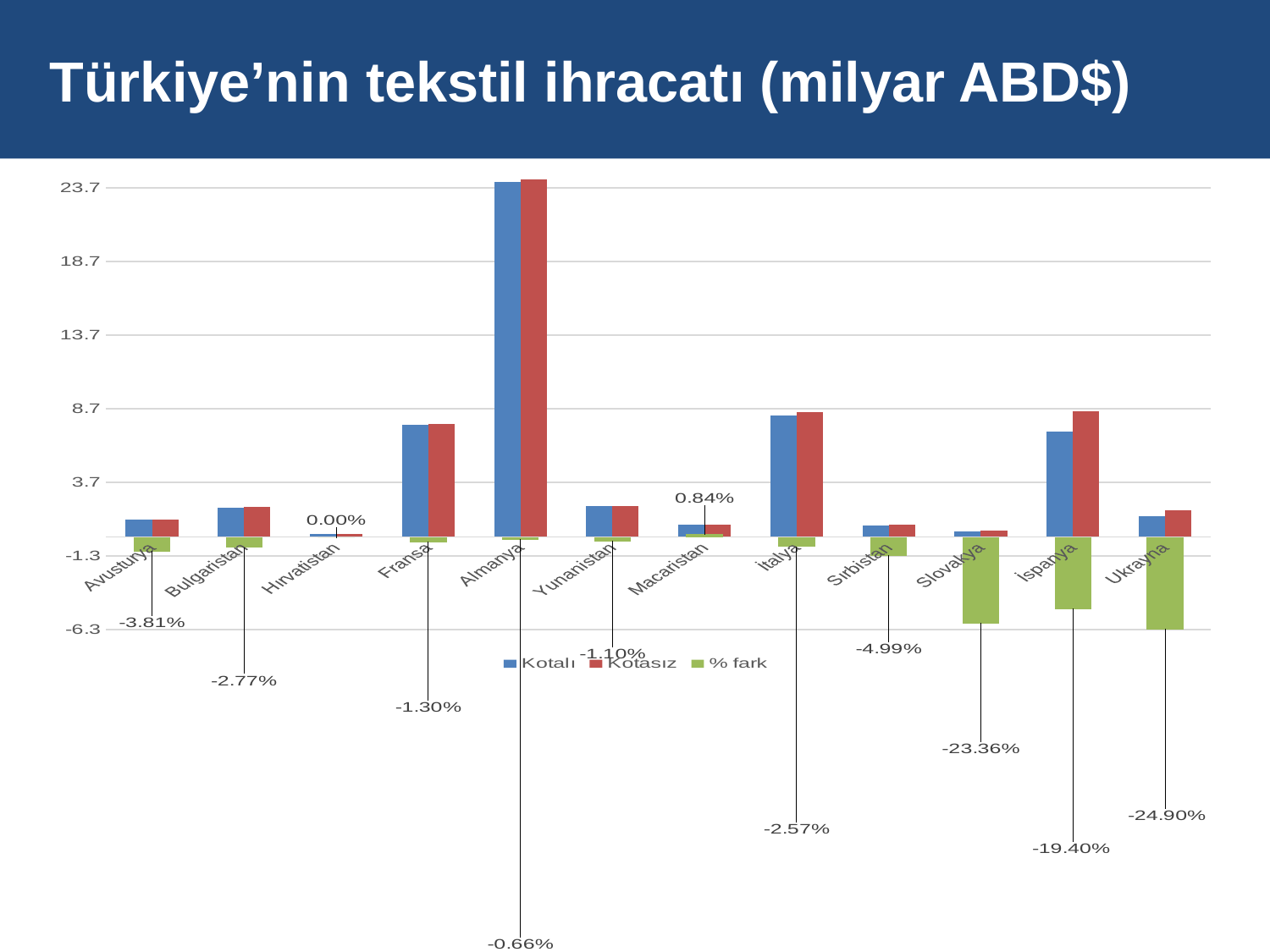
Which has a larger % fark value, İspanya or Sırbistan? Sırbistan What is the % fark value for Hırvatistan? 0.00% What is the % fark value for Macaristan? 0.84% What kind of chart is shown on the slide? Bar chart What is the difference in percentage points between the % fark values for Ukrayna and Slovakya? 1.54 Which country has the lowest % fark value? Ukrayna How many countries are shown on the x axis? 12 What is the % fark value for Slovakya? -23.36% Is the Kotalı value for Almanya greater or less than 18.7? greater Which country has the highest % fark value? Macaristan How many series does the legend list? 3 What is the % fark value for Ukrayna? -24.90%